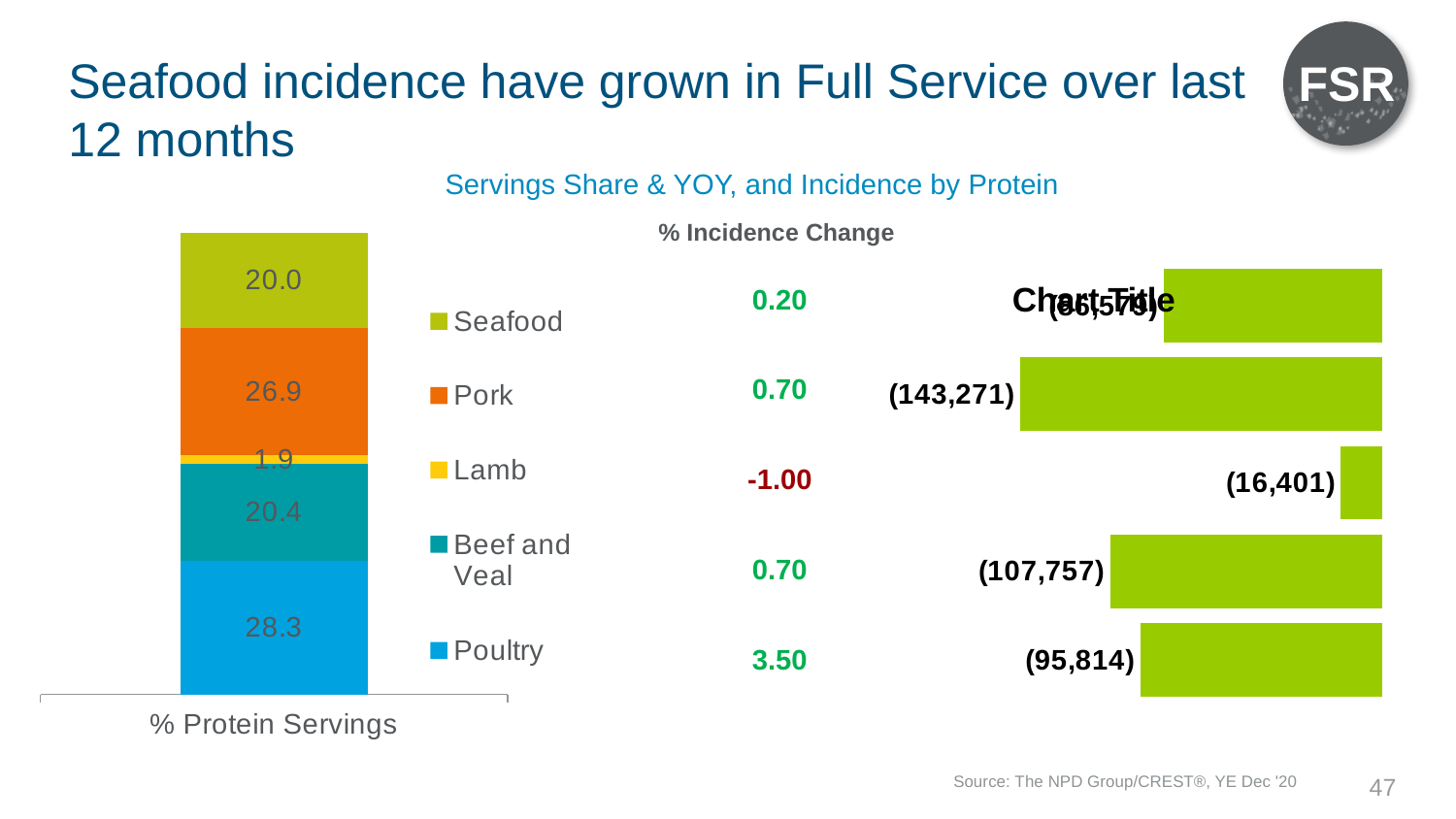
In the stacked bar chart on the left, what is the difference between the Pork value and the Seafood value? 6.9 In the stacked bar chart on the left, what is the value shown for Poultry? 28.3 In the horizontal bar chart on the right, what is the data label on the bar in the row aligned with Pork? (143,271) In the % Incidence Change column, what is the value for Poultry? 3.50 In the stacked bar chart on the left, which protein has the largest segment? Poultry How many series does the legend of the stacked bar chart list? 5 In the stacked bar chart on the left, which protein has the smallest segment? Lamb What kind of chart is the chart on the left labelled % Protein Servings? Stacked bar chart In the % Incidence Change column, what is the value for Lamb? -1.00 What is the total of the stacked bar in the % Protein Servings chart? 97.5 In the stacked bar chart on the left, which is larger: the Pork segment or the Beef and Veal segment? Pork In the stacked bar chart on the left, what is the value shown for Seafood? 20.0